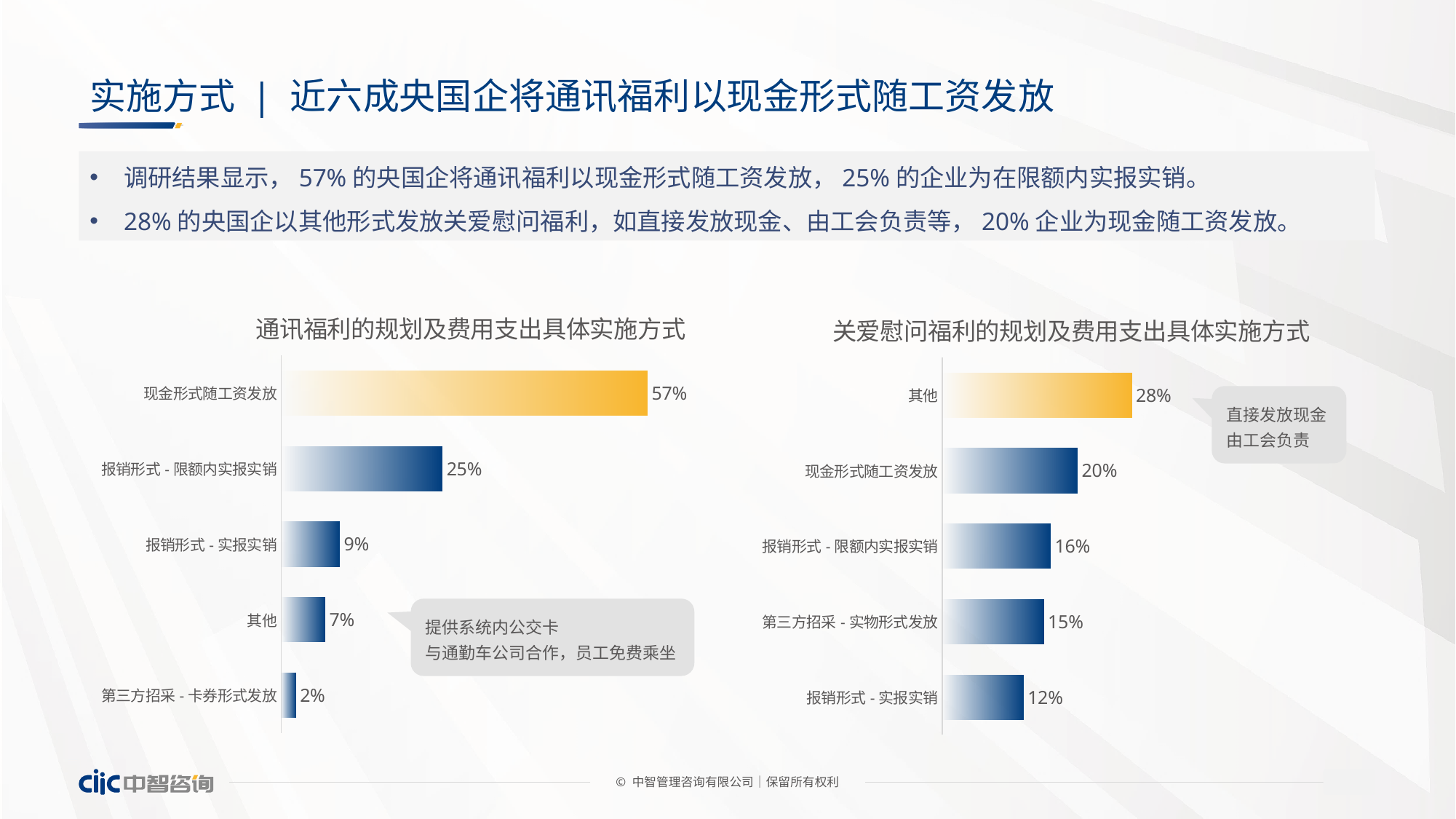
In the left chart titled 通讯福利的规划及费用支出具体实施方式, what is the difference between 现金形式随工资发放 and 报销形式 - 限额内实报实销? 32% What kind of chart is the left chart titled 通讯福利的规划及费用支出具体实施方式? Bar chart In the right chart titled 关爱慰问福利的规划及费用支出具体实施方式, how many categories are shown? 5 In the right chart titled 关爱慰问福利的规划及费用支出具体实施方式, what is the value for 其他? 28% In the right chart titled 关爱慰问福利的规划及费用支出具体实施方式, what is the value for 第三方招采 - 实物形式发放? 15% In the left chart titled 通讯福利的规划及费用支出具体实施方式, what is the value for 现金形式随工资发放? 57% In the right chart titled 关爱慰问福利的规划及费用支出具体实施方式, which category has the highest value? 其他 In the left chart titled 通讯福利的规划及费用支出具体实施方式, what is the value for 报销形式 - 限额内实报实销? 25% In the right chart titled 关爱慰问福利的规划及费用支出具体实施方式, which is larger: 现金形式随工资发放 or 报销形式 - 实报实销? 现金形式随工资发放 In the left chart titled 通讯福利的规划及费用支出具体实施方式, how many categories are shown? 5 In the left chart titled 通讯福利的规划及费用支出具体实施方式, which category has the lowest value? 第三方招采 - 卡券形式发放 In the right chart titled 关爱慰问福利的规划及费用支出具体实施方式, what is the difference between 其他 and 报销形式 - 实报实销? 16%